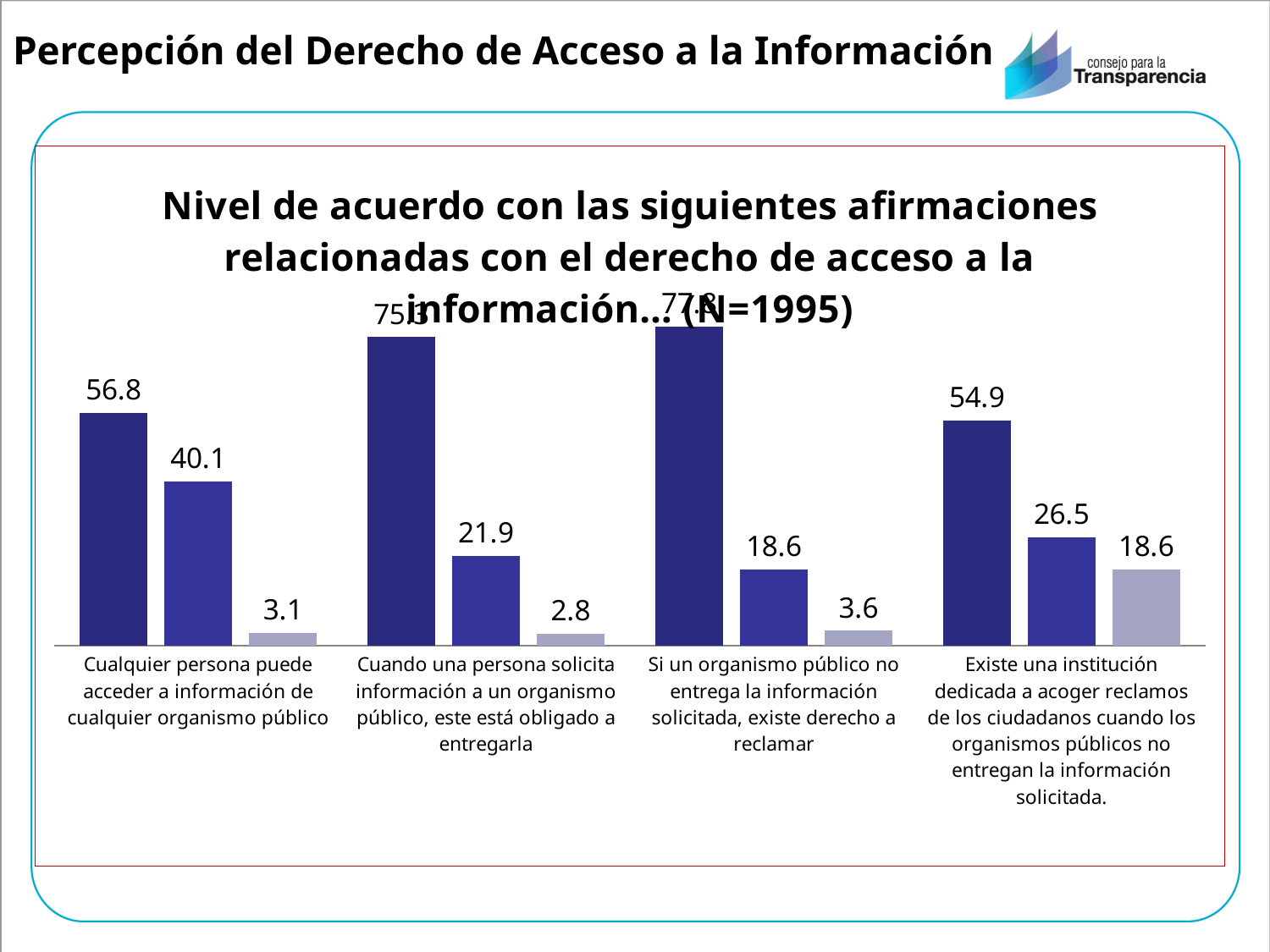
What is the value of the middle (medium blue) bar for "Existe una institución dedicada a acoger reclamos de los ciudadanos cuando los organismos públicos no entregan la información solicitada"? 26.5 What is the difference between the dark blue bar (56.8) and the medium blue bar (40.1) for "Cualquier persona puede acceder a información de cualquier organismo público"? 16.7 What type of chart is shown on the slide? Bar chart Which category has the lowest light grey bar? Cuando una persona solicita información a un organismo público, este está obligado a entregarla How many bars are shown for each category? 3 Which category has the highest light grey bar? Existe una institución dedicada a acoger reclamos de los ciudadanos cuando los organismos públicos no entregan la información solicitada. Which is larger: the medium blue bar for "Cualquier persona puede acceder a información de cualquier organismo público" or the medium blue bar for "Existe una institución dedicada a acoger reclamos..."? Cualquier persona puede acceder a información de cualquier organismo público What is the value of the dark blue bar for "Cualquier persona puede acceder a información de cualquier organismo público"? 56.8 What is the difference between the medium blue bar (26.5) and the light grey bar (18.6) for "Existe una institución dedicada a acoger reclamos..."? 7.9 How many categories (statements) are shown on the x axis? 4 What is the value of the middle (medium blue) bar for "Si un organismo público no entrega la información solicitada, existe derecho a reclamar"? 18.6 What is the value of the light grey bar for "Cuando una persona solicita información a un organismo público, este está obligado a entregarla"? 2.8